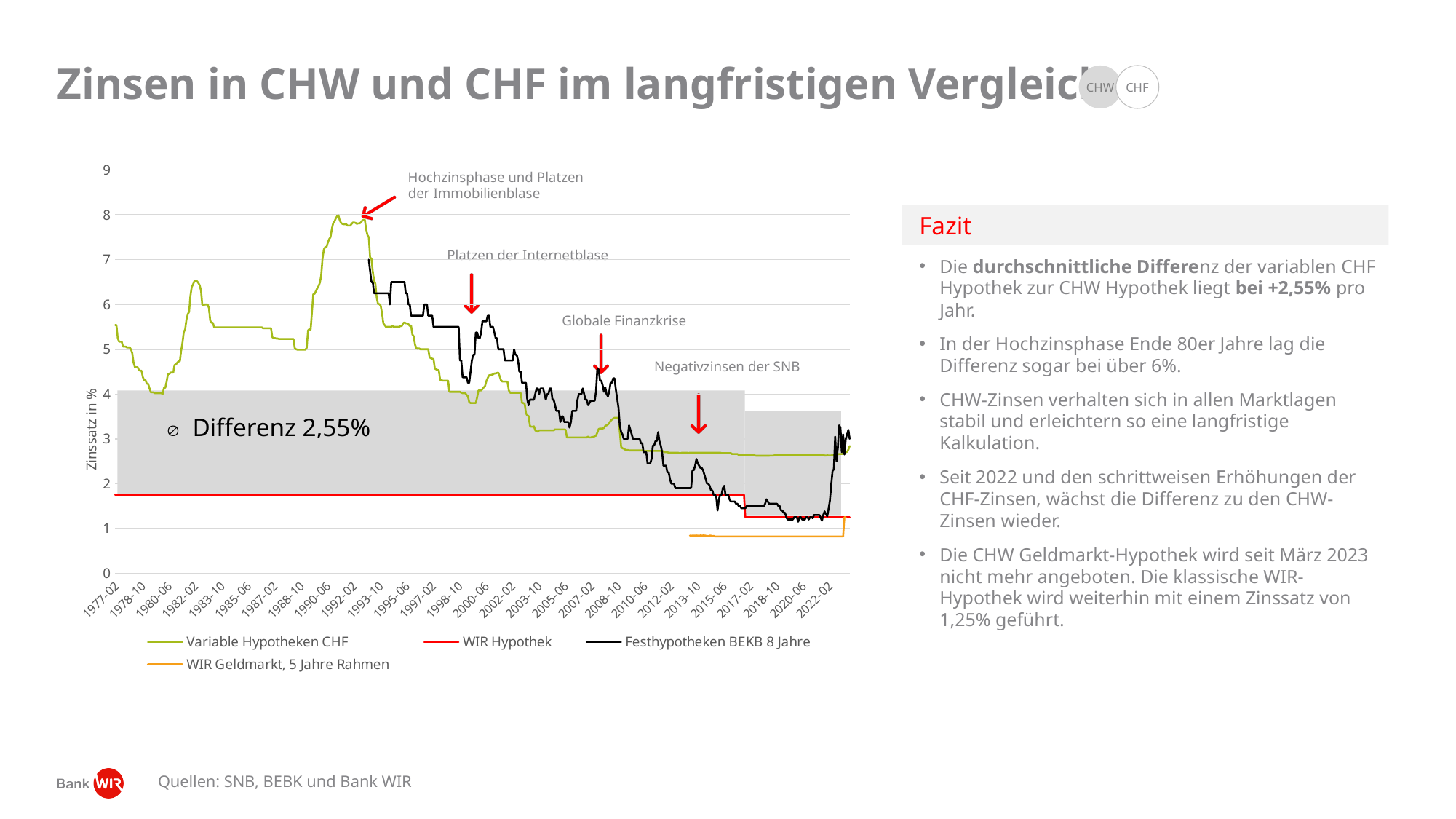
Between 1990-06 and 2020-06, does the Variable Hypotheken CHF series generally rise or fall? fall Before 2017, is the value for WIR Hypothek greater or less than 2? less Which series has the lowest values on the chart? WIR Geldmarkt, 5 Jahre Rahmen Which series reaches the highest value anywhere on the chart? Variable Hypotheken CHF Around 1990-06, is the value for Variable Hypotheken CHF greater or less than 7? greater What kind of chart is shown on the slide? line chart What is the title of the vertical axis of the chart? Zinssatz in % Around 2020-06, is the value for Festhypotheken BEKB 8 Jahre greater or less than 2? less What difference value is printed inside the grey shaded area of the chart? Differenz 2,55% Around 1990-06, which series has the higher value: Variable Hypotheken CHF or WIR Hypothek? Variable Hypotheken CHF How many series does the legend of the chart list? 4